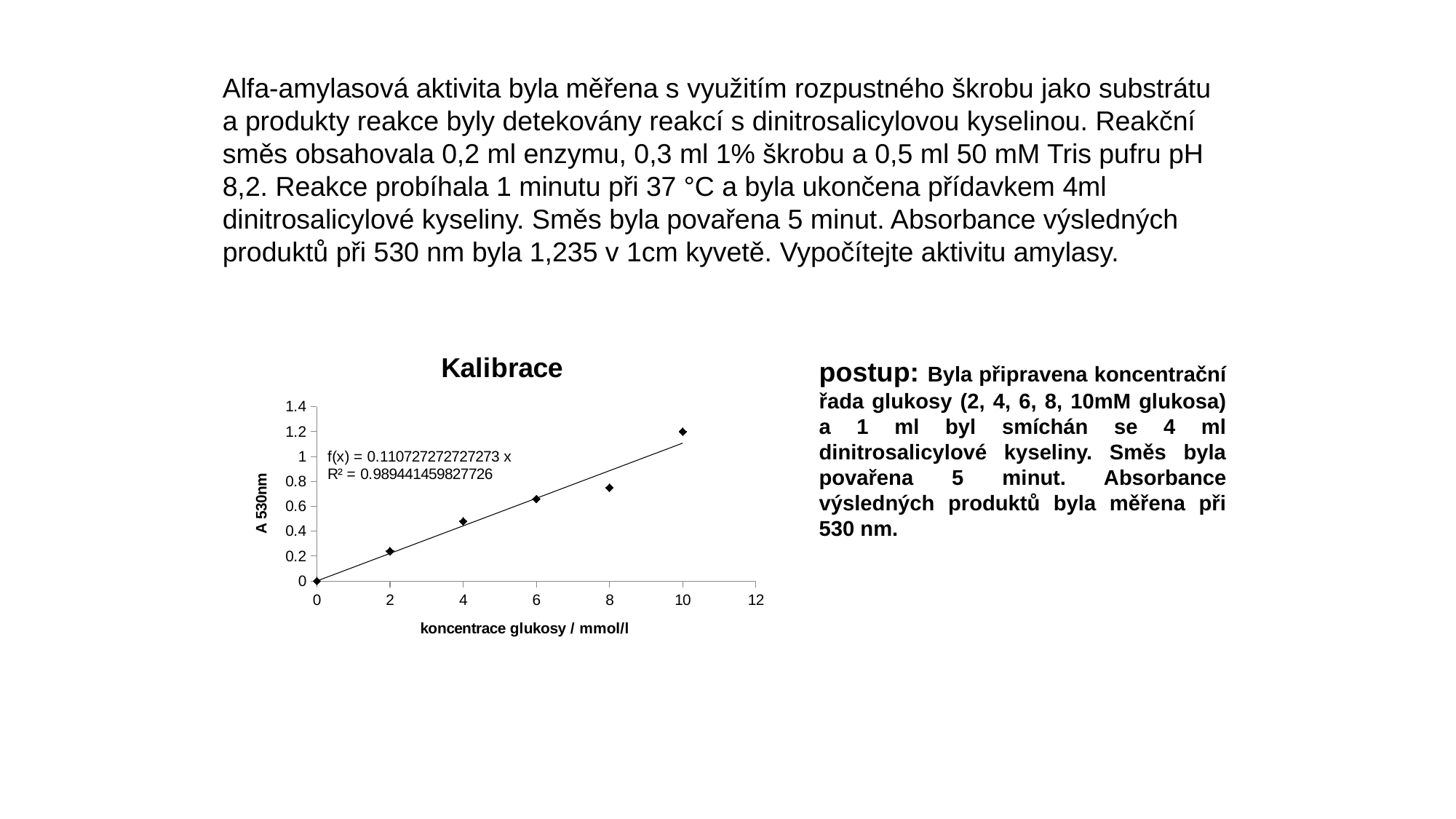
Which has the higher absorbance: the point at 6 mmol/l or the point at 8 mmol/l? 8 mmol/l What is the title of the chart? Kalibrace Is the absorbance value at a glucose concentration of 8 mmol/l greater or less than 0.6? greater At which glucose concentration is the absorbance lowest? 0 What kind of chart is shown on the slide? scatter plot How many data points are plotted in the chart? 6 Is the absorbance value at a glucose concentration of 2 mmol/l greater or less than 0.4? less What is the label of the x axis of the chart? koncentrace glukosy / mmol/l Is the absorbance value at a glucose concentration of 10 mmol/l greater or less than 1? greater Do the absorbance values rise or fall as glucose concentration increases along the x axis? rise At which glucose concentration is the absorbance highest? 10